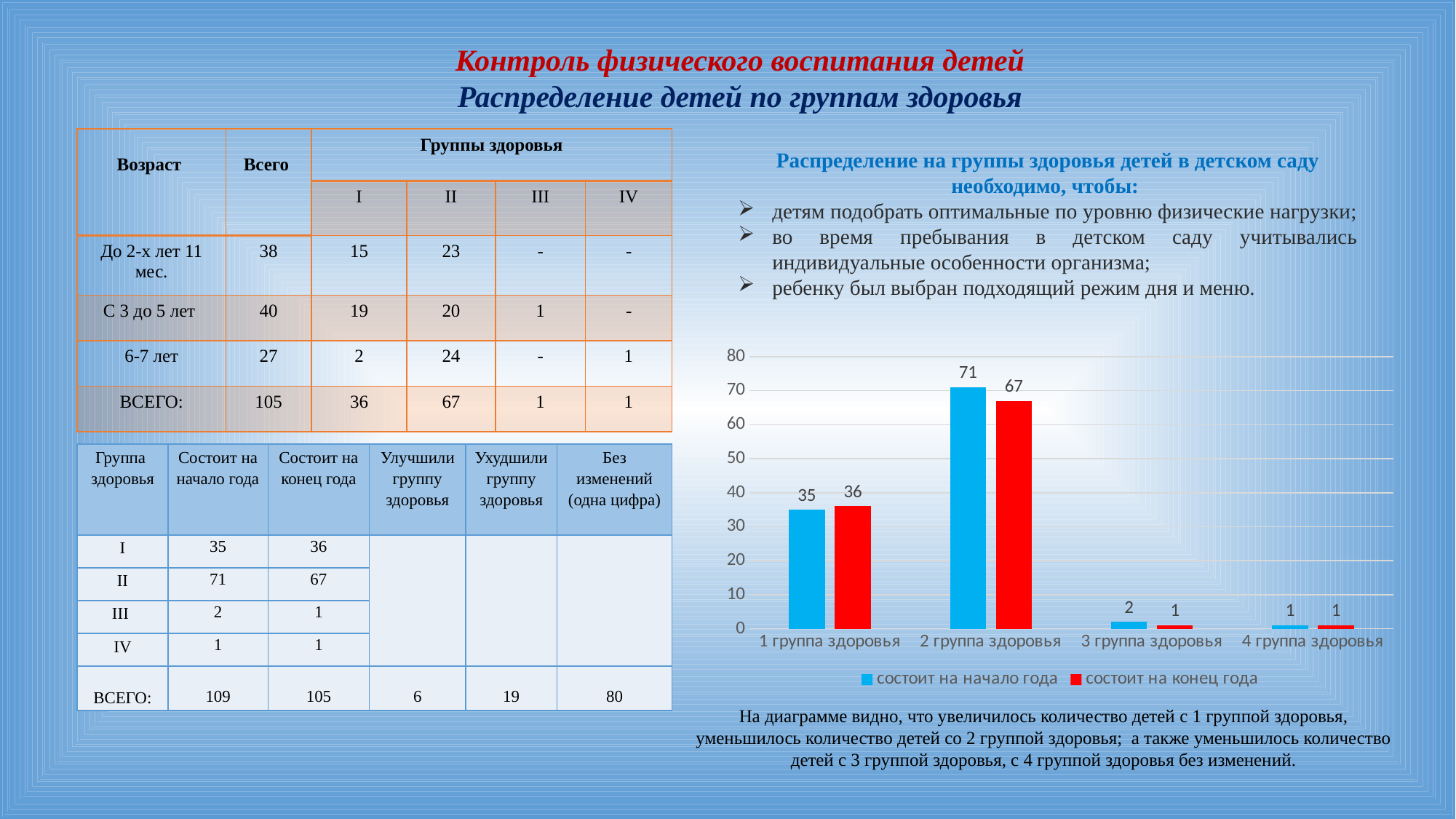
What is the value for "2 группа здоровья" in the series "состоит на начало года"? 71 For "1 группа здоровья", which is larger: the value for "состоит на начало года" or "состоит на конец года"? состоит на конец года Which category has the highest value in the series "состоит на начало года"? 2 группа здоровья How many series does the chart legend list? 2 What type of chart is shown on the slide? bar chart Which colour represents the series "состоит на конец года" in the chart? red What is the difference between the start-of-year and end-of-year values for "2 группа здоровья"? 4 What is the value for "3 группа здоровья" in the series "состоит на начало года"? 2 What is the value for "1 группа здоровья" in the series "состоит на конец года"? 36 How many categories are shown on the x axis of the chart? 4 Is the value for "2 группа здоровья" in the series "состоит на конец года" greater or less than 60? greater What is the value for "2 группа здоровья" in the series "состоит на конец года"? 67